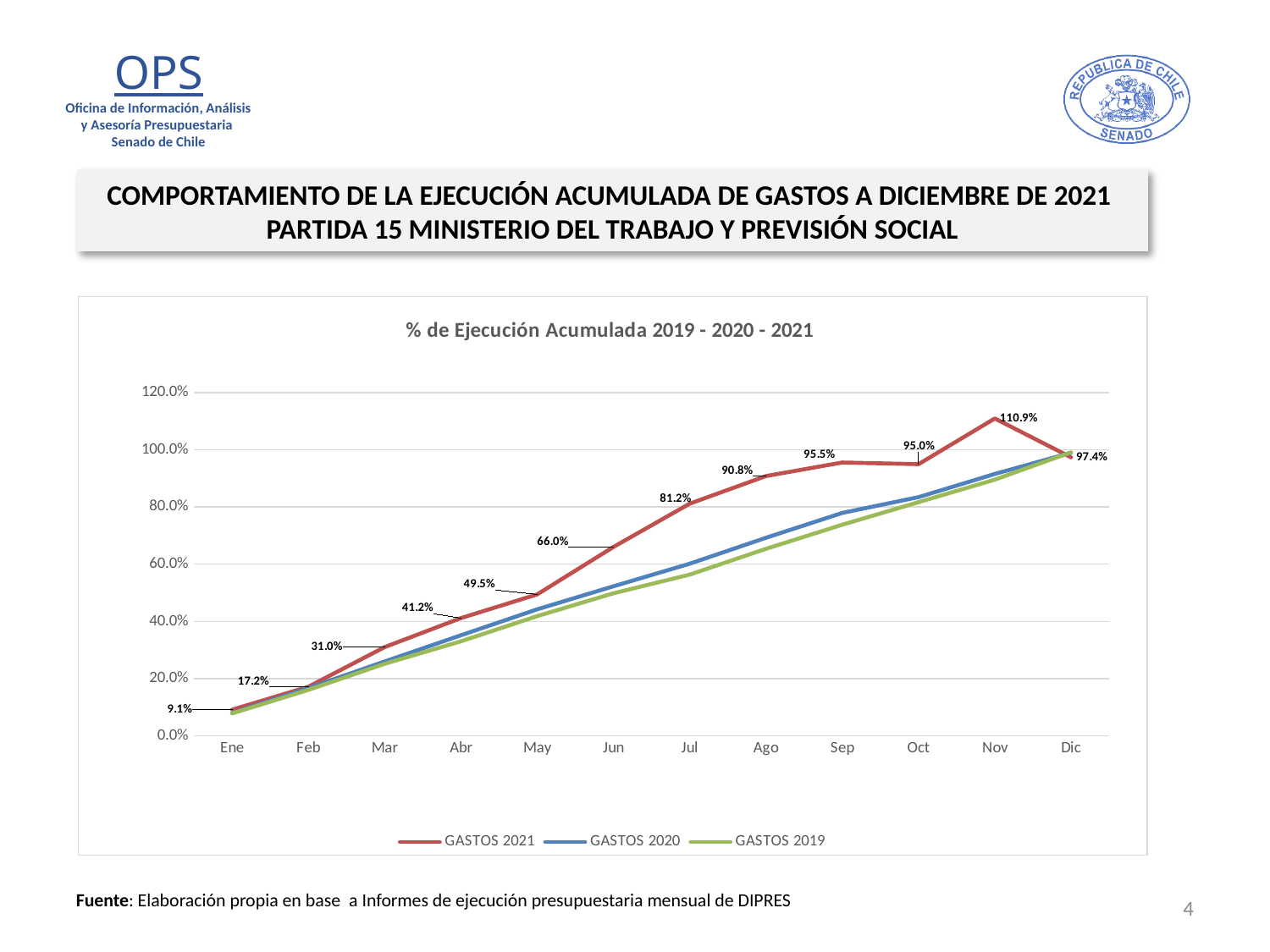
What is the value for GASTOS 2021 in Ene? 9.1% In which month is GASTOS 2021 at its lowest value? Ene How many months are shown on the x axis? 12 Is the value for GASTOS 2020 in Sep greater or less than 60.0%? greater What is the value for GASTOS 2021 in Jun? 66.0% What is the difference between the GASTOS 2021 values for Nov and Dic? 13.5% Which is larger for GASTOS 2021: the value in Sep or the value in Oct? Sep What is the value for GASTOS 2021 in Nov? 110.9% How many series does the legend list? 3 What is the chart's title? % de Ejecución Acumulada 2019 - 2020 - 2021 What type of chart is shown on the slide? line chart In which month does GASTOS 2021 reach its highest value? Nov